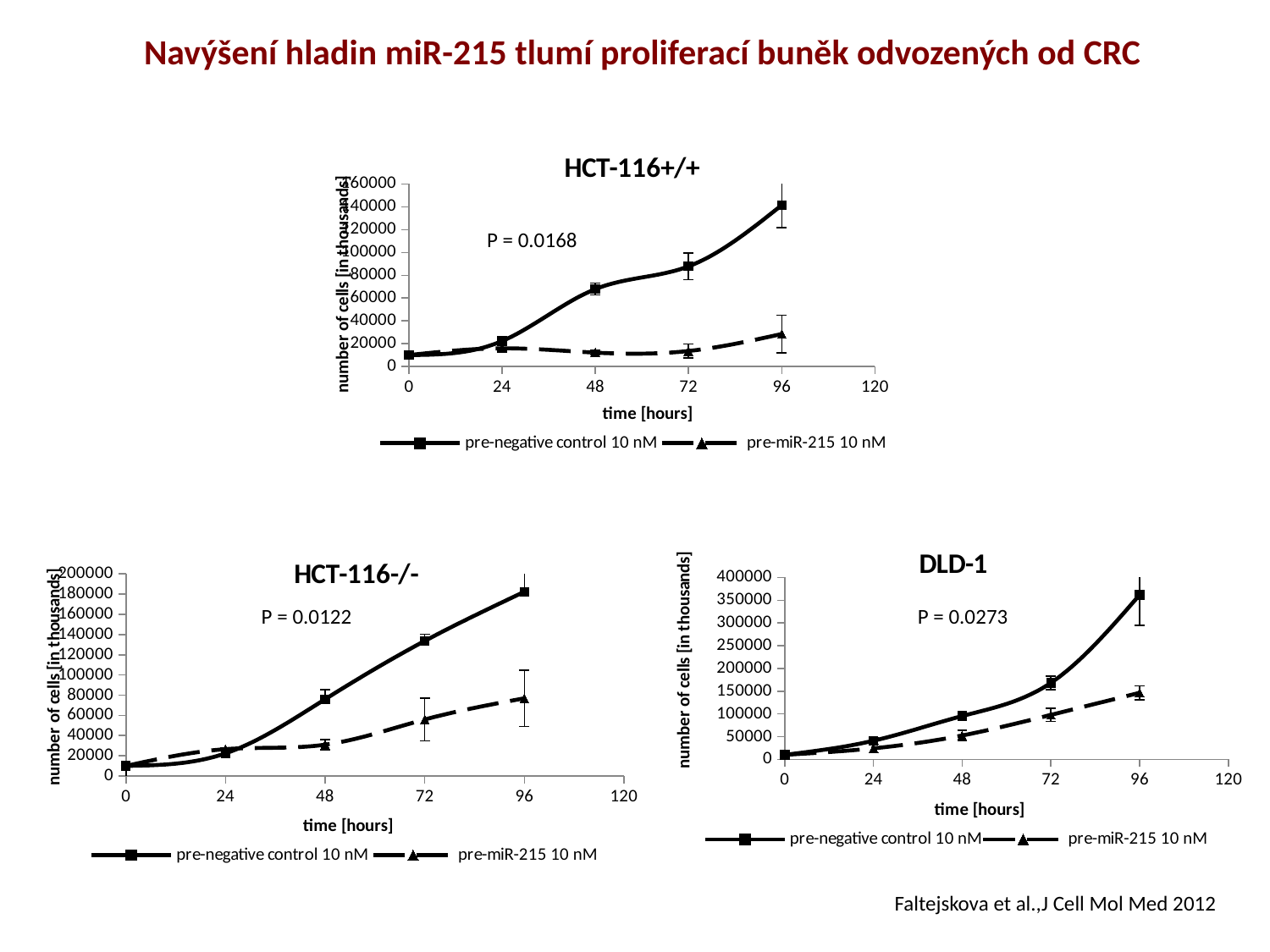
In the HCT-116-/- chart, does the pre-negative control 10 nM series rise or fall as time increases? rise In the DLD-1 chart, which series has the higher value at 96 hours, pre-negative control 10 nM or pre-miR-215 10 nM? pre-negative control 10 nM What kind of chart is the HCT-116+/+ chart? line chart In the HCT-116-/- chart, is the value for pre-miR-215 10 nM at 96 hours greater or less than 100000? less In the DLD-1 chart, is the value for pre-negative control 10 nM at 96 hours greater or less than 300000? greater In the HCT-116+/+ chart, is the value for pre-miR-215 10 nM at 96 hours greater or less than 40000? less What P value is shown on the DLD-1 chart? P = 0.0273 How many time points are plotted for each series in the HCT-116-/- chart? 5 How many series does the legend of the DLD-1 chart list? 2